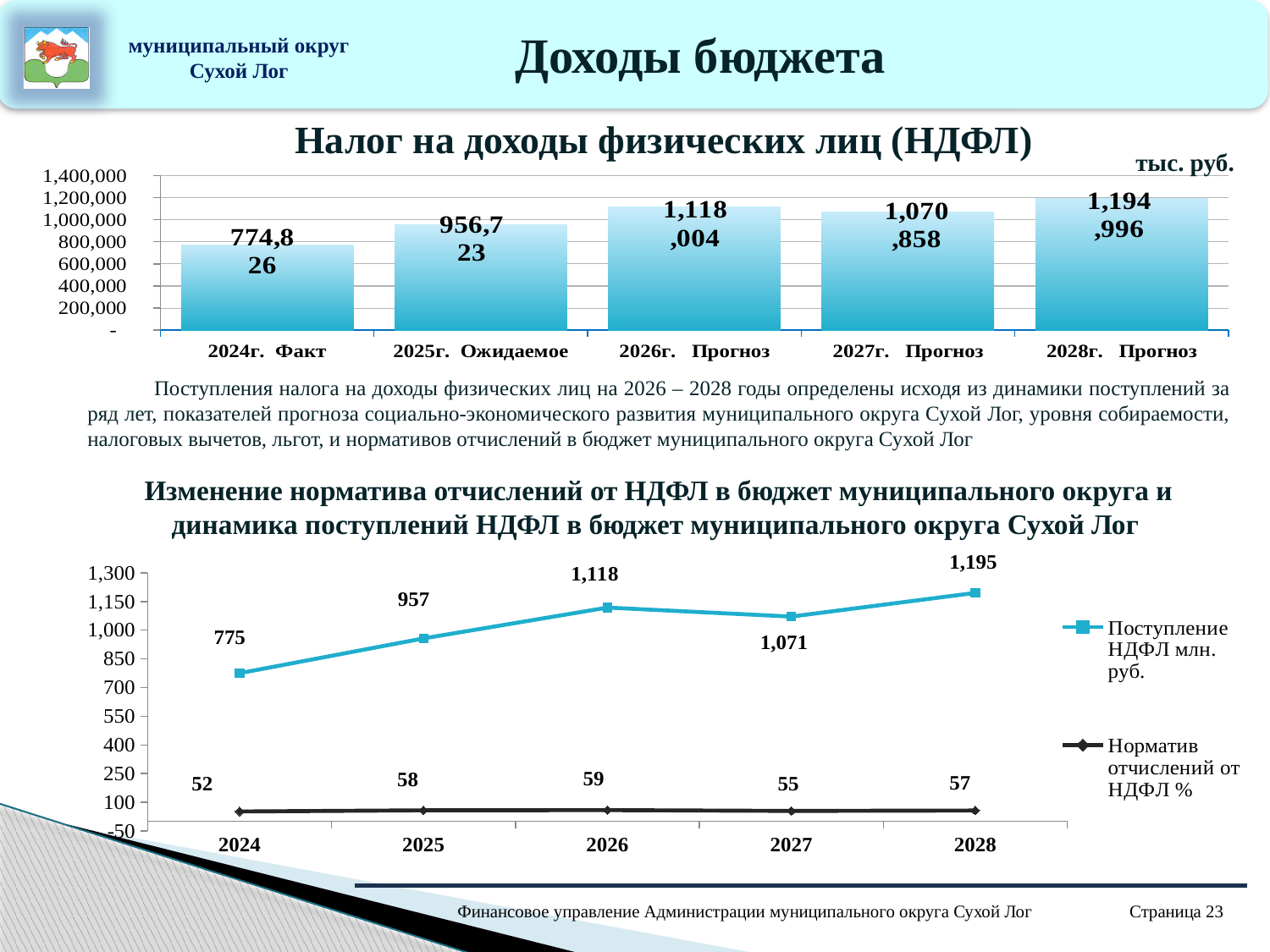
In the bottom line chart, what is the value of Норматив отчислений от НДФЛ % for 2027? 55 In the top bar chart (Налог на доходы физических лиц), what is the value for 2024г. Факт? 774,826 What type of chart is the bottom chart on the slide? Line chart In the bottom line chart, in which year is Норматив отчислений от НДФЛ % highest? 2026 In the bottom line chart, what is the difference between Поступление НДФЛ млн. руб. in 2028 and in 2024? 420 In the top bar chart (Налог на доходы физических лиц), which category has the highest value? 2028г. Прогноз In the top bar chart (Налог на доходы физических лиц), which category has the lowest value? 2024г. Факт In the bottom line chart, how many series does the legend list? 2 In the bottom line chart, what is the value of Поступление НДФЛ млн. руб. for 2026? 1,118 In the top bar chart (Налог на доходы физических лиц), how many bars are shown? 5 In the top bar chart (Налог на доходы физических лиц), what is the value for 2027г. Прогноз? 1,070,858 In the top bar chart (Налог на доходы физических лиц), what unit is indicated above the chart? тыс. руб.